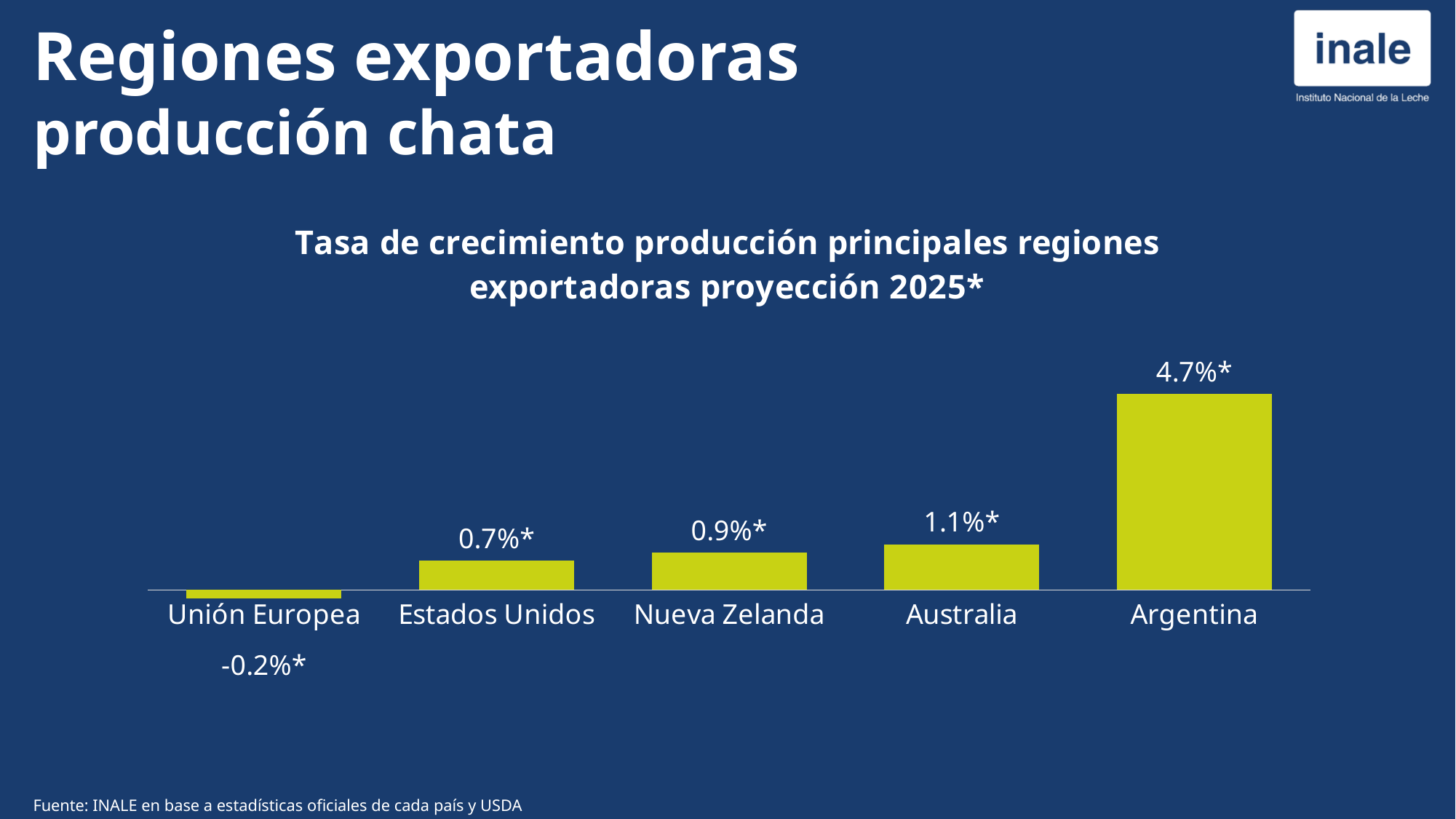
Do the values rise or fall from left to right across the regions? Rise Which has a higher projected growth rate, Australia or Nueva Zelanda? Australia What is the projected 2025 production growth rate for Nueva Zelanda? 0.9%* What is the projected 2025 production growth rate for Argentina? 4.7%* What is the projected 2025 production growth rate for Estados Unidos? 0.7%* What is the title of the chart? Tasa de crecimiento producción principales regiones exportadoras proyección 2025* How many regions are shown in the chart? 5 Which region has the highest projected growth rate? Argentina Which region has the lowest projected growth rate? Unión Europea What is the projected 2025 production growth rate for Unión Europea? -0.2%* What kind of chart is shown on the slide? Bar chart What is the difference between the growth rates of Argentina and Australia? 3.6%